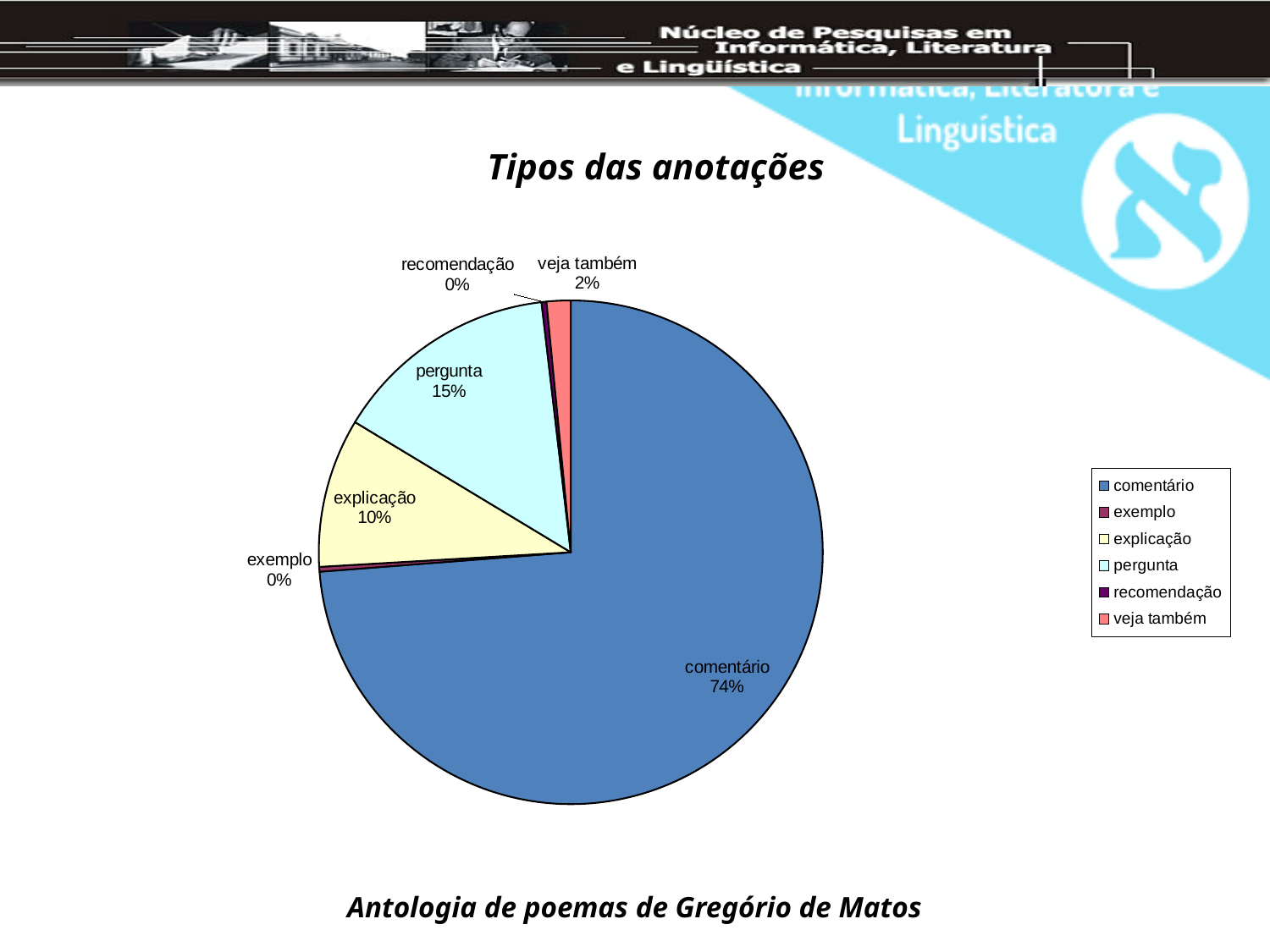
What share of the pie does explicação have? 10% What percentage is shown for recomendação? 0% Which category has the largest slice of the pie? comentário What share of the pie does veja também have? 2% What is the difference in percentage points between pergunta and explicação? 5 What share of the pie does comentário have? 74% What kind of chart is shown on the slide? pie chart What is the difference in percentage points between comentário and pergunta? 59 What is the title of the chart? Tipos das anotações Which is larger, pergunta or explicação? pergunta How many categories does the legend list? 6